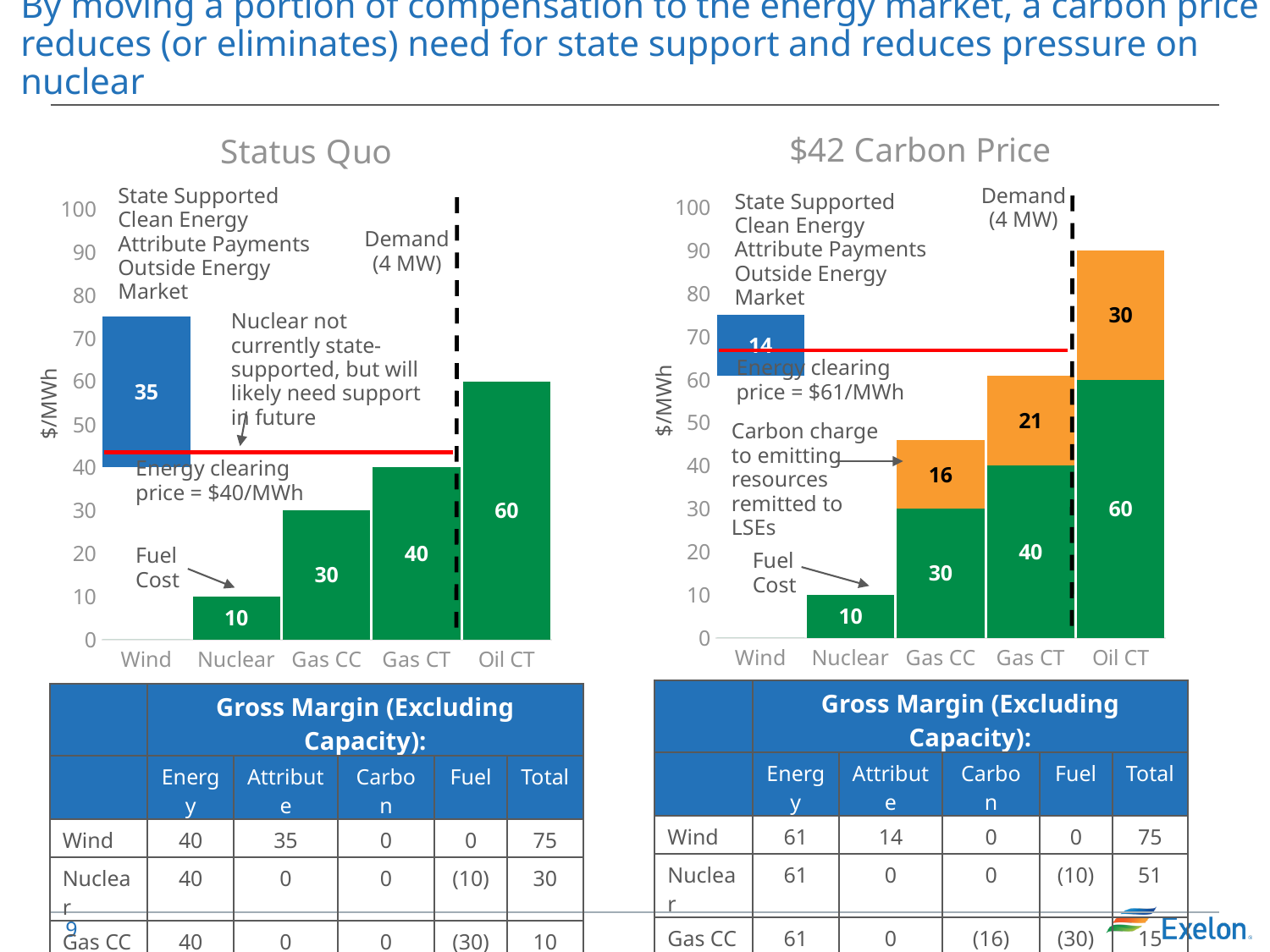
In the $42 Carbon Price chart, what value is labeled on the Wind bar? 14 In the $42 Carbon Price chart, what is the total height of the stacked Gas CC bar (fuel cost plus carbon charge)? 46 What kind of chart is the $42 Carbon Price chart? Bar chart In the $42 Carbon Price chart, what is the carbon charge (orange segment) labeled on the Gas CT bar? 21 In the Status Quo chart, what is the fuel cost value labeled on the Oil CT bar? 60 In the Status Quo chart, what is the difference between the Oil CT fuel cost and the Gas CT fuel cost? 20 How many categories are shown on the x axis of the Status Quo chart? 5 In the Status Quo chart, what value is labeled on the Wind bar? 35 In the $42 Carbon Price chart, which is larger: the carbon charge on Gas CC or the carbon charge on Oil CT? Oil CT What energy clearing price is stated on the $42 Carbon Price chart? $61/MWh In the Status Quo chart, which category has the lowest labeled fuel cost? Nuclear In the $42 Carbon Price chart, what is the total height of the stacked Oil CT bar (fuel cost plus carbon charge)? 90